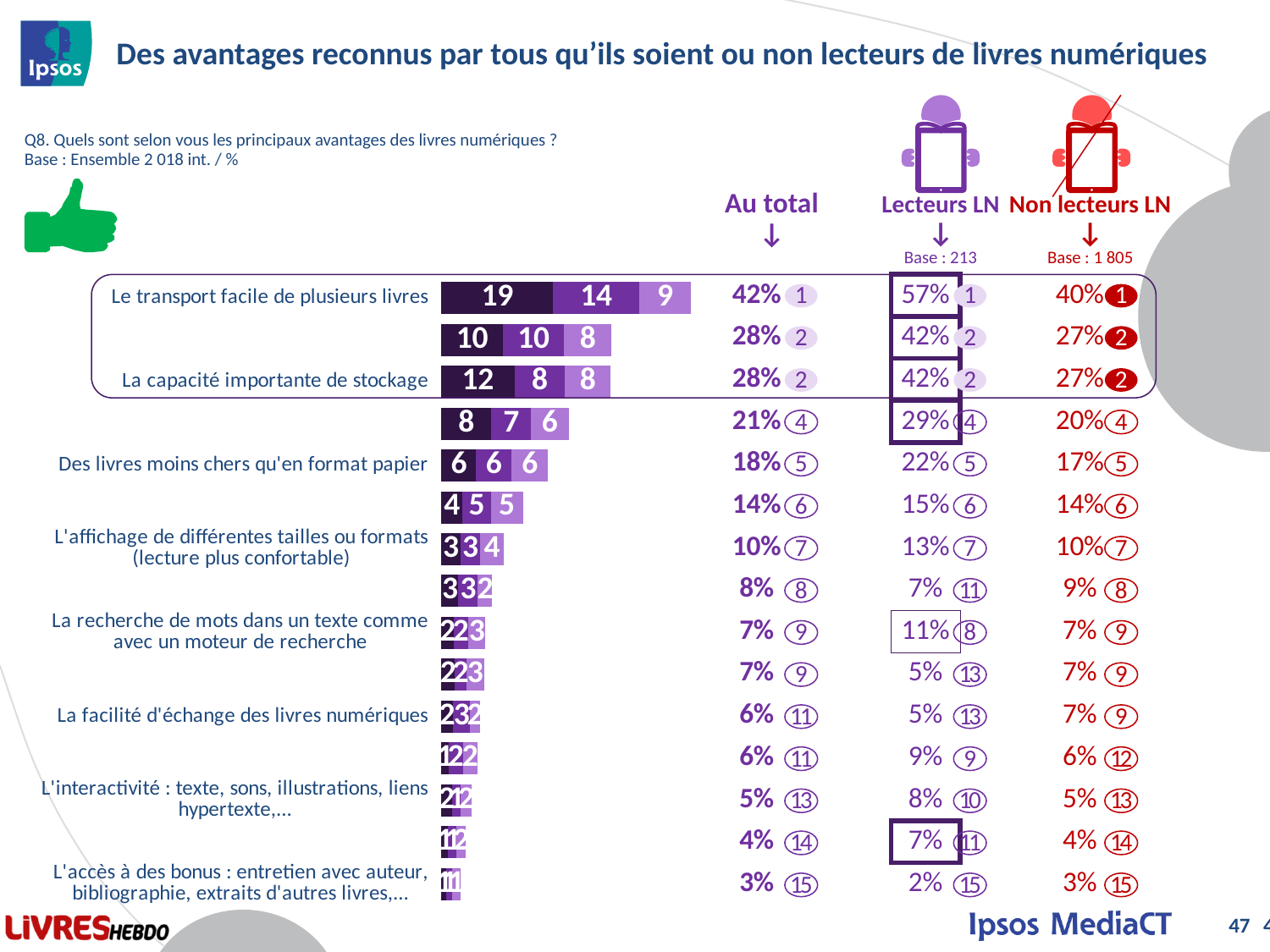
What is the difference between the 'Lecteurs LN' and 'Non lecteurs LN' values for 'Le transport facile de plusieurs livres'? 17 points What kind of chart is shown on the slide? bar chart What is the 'Au total' value for 'Le transport facile de plusieurs livres'? 42% How many bars (categories) are plotted in the chart? 15 What is the 'Non lecteurs LN' value for 'Des livres moins chers qu'en format papier'? 17% What is the total of the three stacked segments in the bar for 'Le transport facile de plusieurs livres'? 42 Which category has the highest 'Au total' value? Le transport facile de plusieurs livres What is the base (number of respondents) shown for 'Lecteurs LN'? 213 What is the 'Lecteurs LN' value for 'Le transport facile de plusieurs livres'? 57% What is the 'Au total' value for 'La capacité importante de stockage'? 28% Which category has the lowest 'Au total' value? L'accès à des bonus : entretien avec auteur, bibliographie, extraits d'autres livres,... Which is larger for 'La facilité d'échange des livres numériques': the 'Lecteurs LN' value or the 'Non lecteurs LN' value? Non lecteurs LN